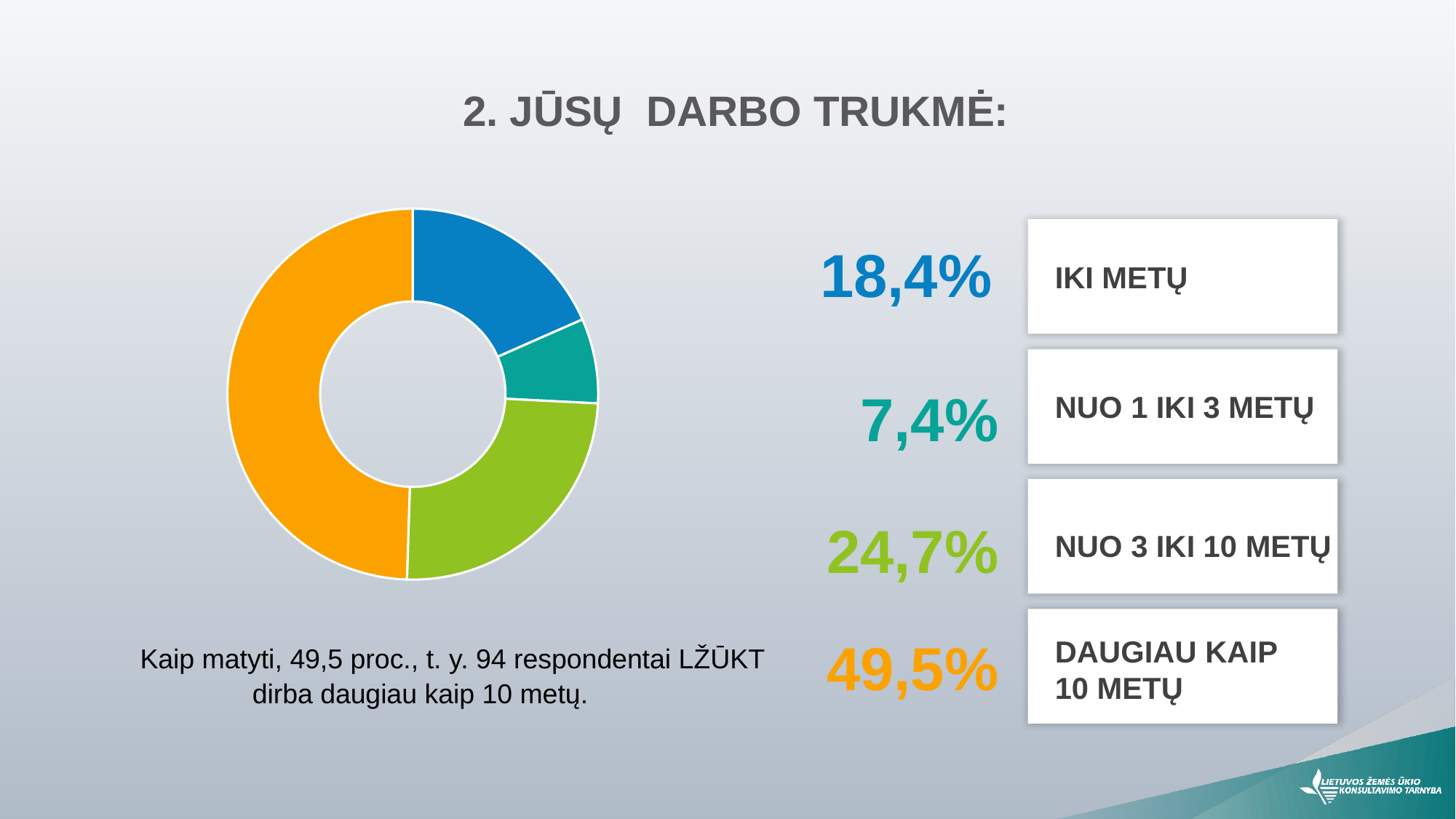
What is the difference in percentage points between DAUGIAU KAIP 10 METŲ and NUO 3 IKI 10 METŲ? 24,8% What colour is the segment for DAUGIAU KAIP 10 METŲ? Orange Which category has the largest share of the chart? DAUGIAU KAIP 10 METŲ How many categories does the chart show? 4 What is the difference in percentage points between NUO 3 IKI 10 METŲ and IKI METŲ? 6,3% What share of respondents have worked DAUGIAU KAIP 10 METŲ? 49,5% What percentage is shown for IKI METŲ? 18,4% What percentage is shown for NUO 1 IKI 3 METŲ? 7,4% Which category has the smallest share of the chart? NUO 1 IKI 3 METŲ What kind of chart is shown on the slide? Donut (pie) chart Which is larger: the share for IKI METŲ or the share for NUO 1 IKI 3 METŲ? IKI METŲ What percentage is shown for NUO 3 IKI 10 METŲ? 24,7%